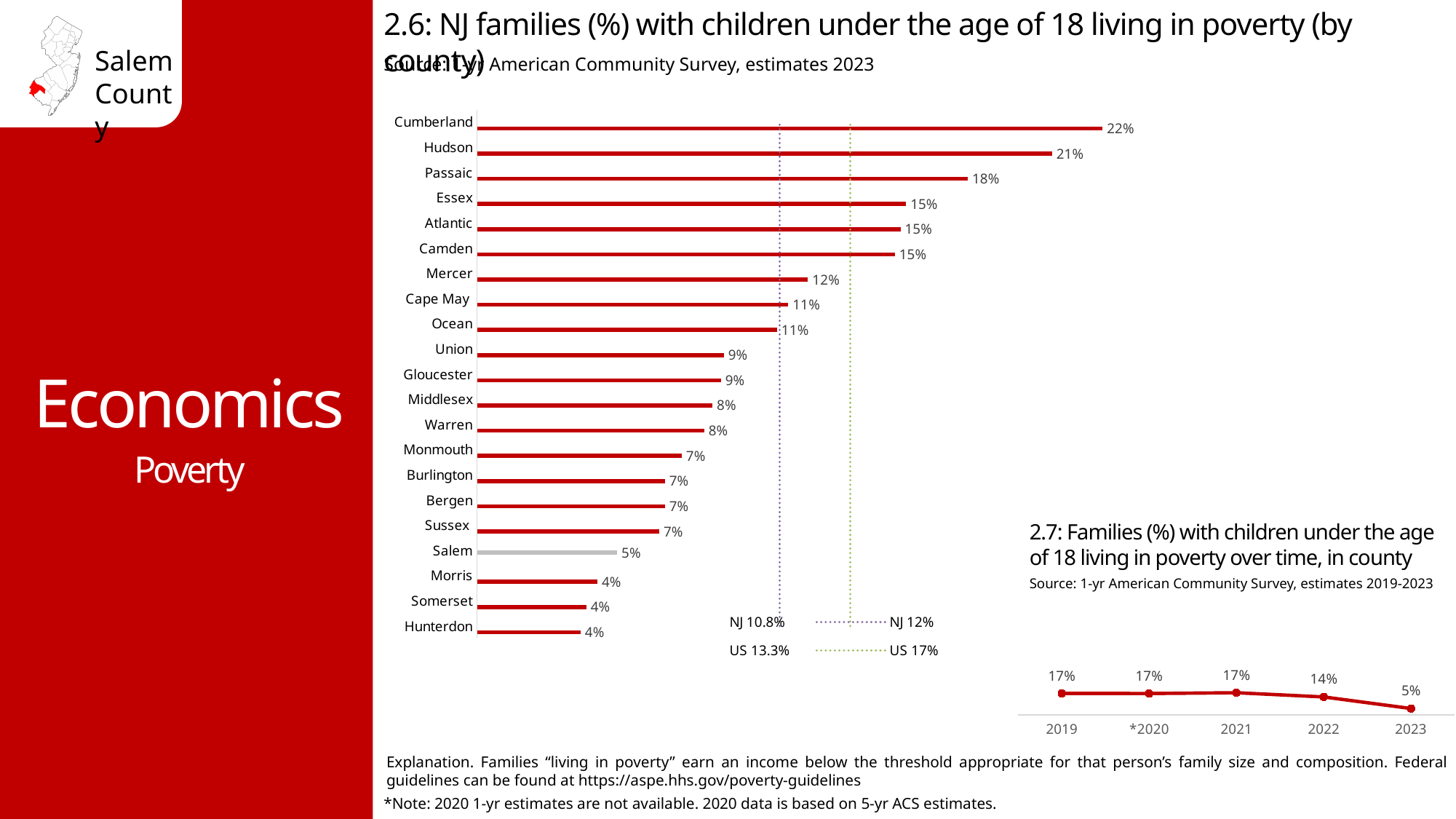
In chart 2.7 (families in poverty over time, in county), what is the value for 2023? 5% In chart 2.6 (by county), what is the value for Cumberland? 22% In chart 2.6 (by county), what is the difference between Cumberland and Salem? 17% In chart 2.6 (by county), which county has the highest value? Cumberland In chart 2.6 (NJ families with children under 18 living in poverty by county), what is the value for Salem? 5% In chart 2.6 (by county), how many counties are plotted? 21 In chart 2.6 (by county), which is larger, the value for Passaic or the value for Mercer? Passaic In chart 2.7 (over time, in county), what is the difference between 2022 and 2023? 9% In chart 2.6 (by county), what is the value for Hudson? 21% In chart 2.7 (over time, in county), do the values rise or fall from 2021 to 2023? Fall What kind of chart is chart 2.6 (by county)? Bar chart